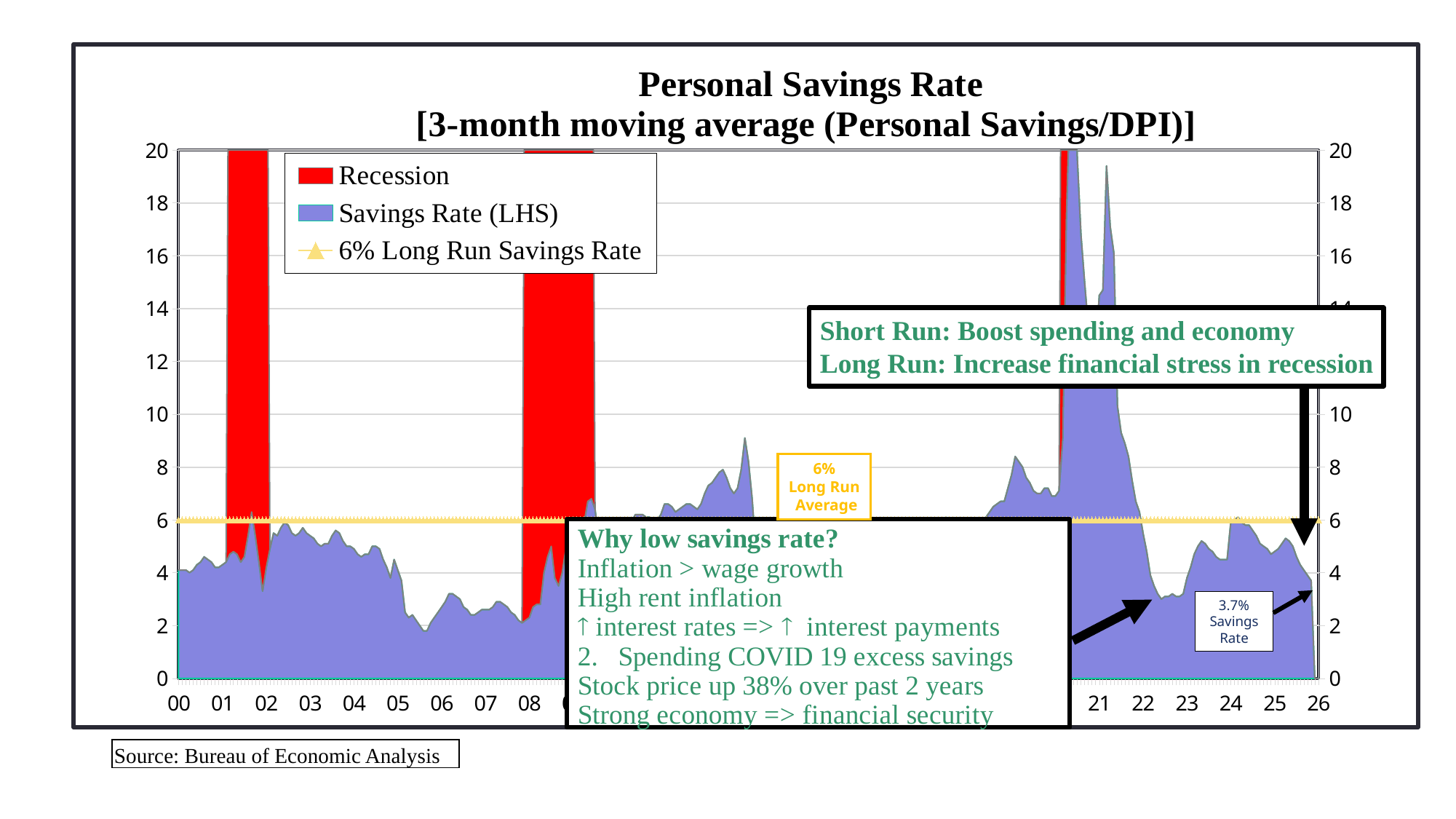
What kind of chart is used to plot the savings rate? area chart Is the savings rate around 2023 greater or less than 6? less How many recession bands are shaded on the chart? 3 Is the savings rate around 2002 greater or less than 8? less What is the value of the long run savings rate line? 6% What is the title of the chart? Personal Savings Rate [3-month moving average (Personal Savings/DPI)] How many entries does the chart legend list? 3 Is the peak savings rate in 2020 greater or less than 16? greater Between 2021 and 2023, does the savings rate rise or fall? fall Which year has the higher savings rate, 2021 or 2023? 2021 What savings rate is annotated near the end of the series (around 2025)? 3.7%